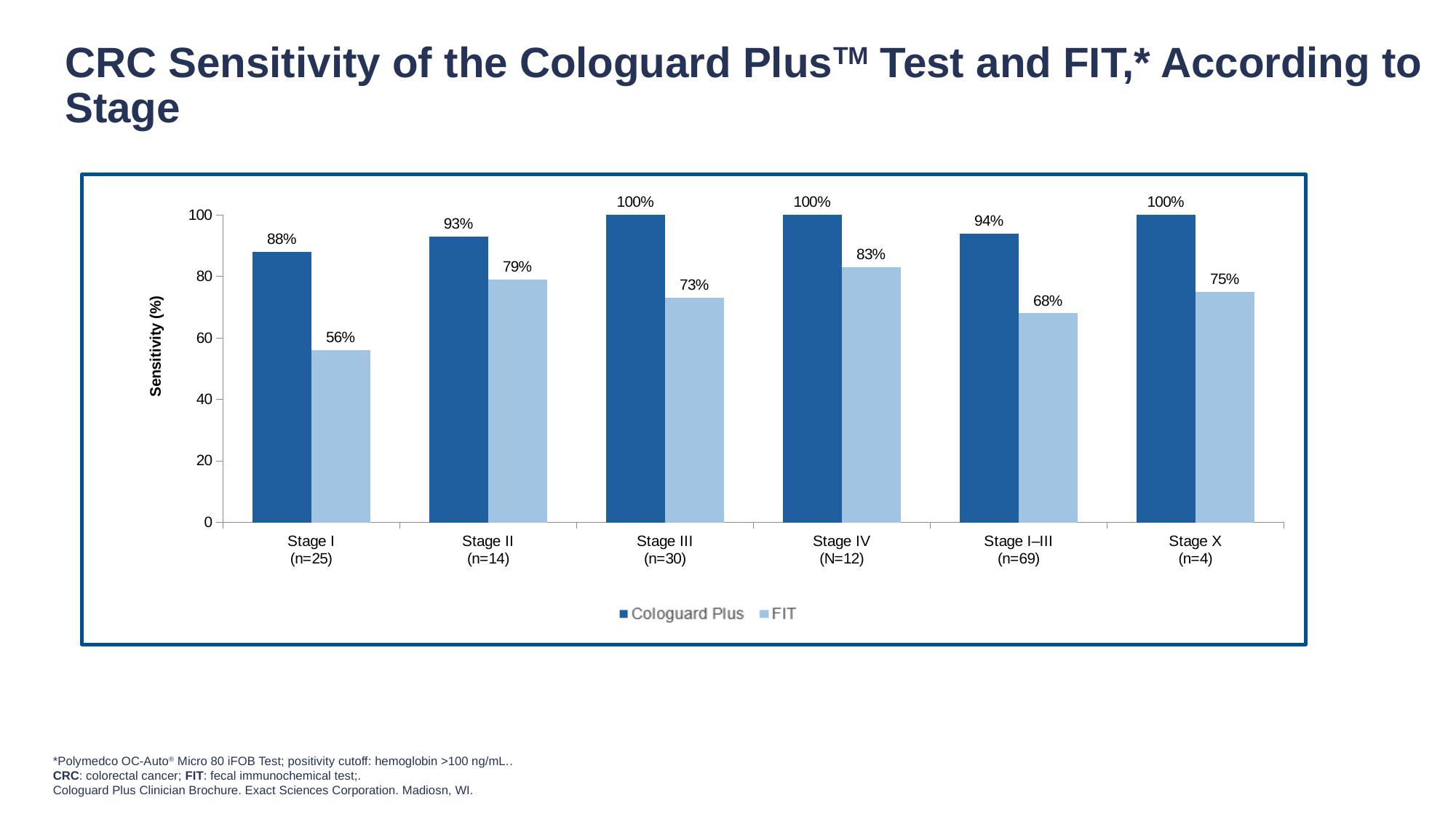
What is the Cologuard Plus sensitivity for Stage I? 88% Which stage has the highest FIT sensitivity? Stage IV What is the FIT sensitivity for Stage II? 79% What is the difference between Cologuard Plus and FIT sensitivity for Stage I? 32% Is the FIT sensitivity for Stage I greater or less than 60? less How many series does the legend list? 2 What is the FIT sensitivity for Stage I–III? 68% What is the difference between Cologuard Plus and FIT sensitivity for Stage X? 25% Which is larger, the FIT sensitivity for Stage III or for Stage IV? Stage IV How many stage categories are shown on the x axis? 6 Which stage has the lowest FIT sensitivity? Stage I What kind of chart is shown on the slide? Bar chart